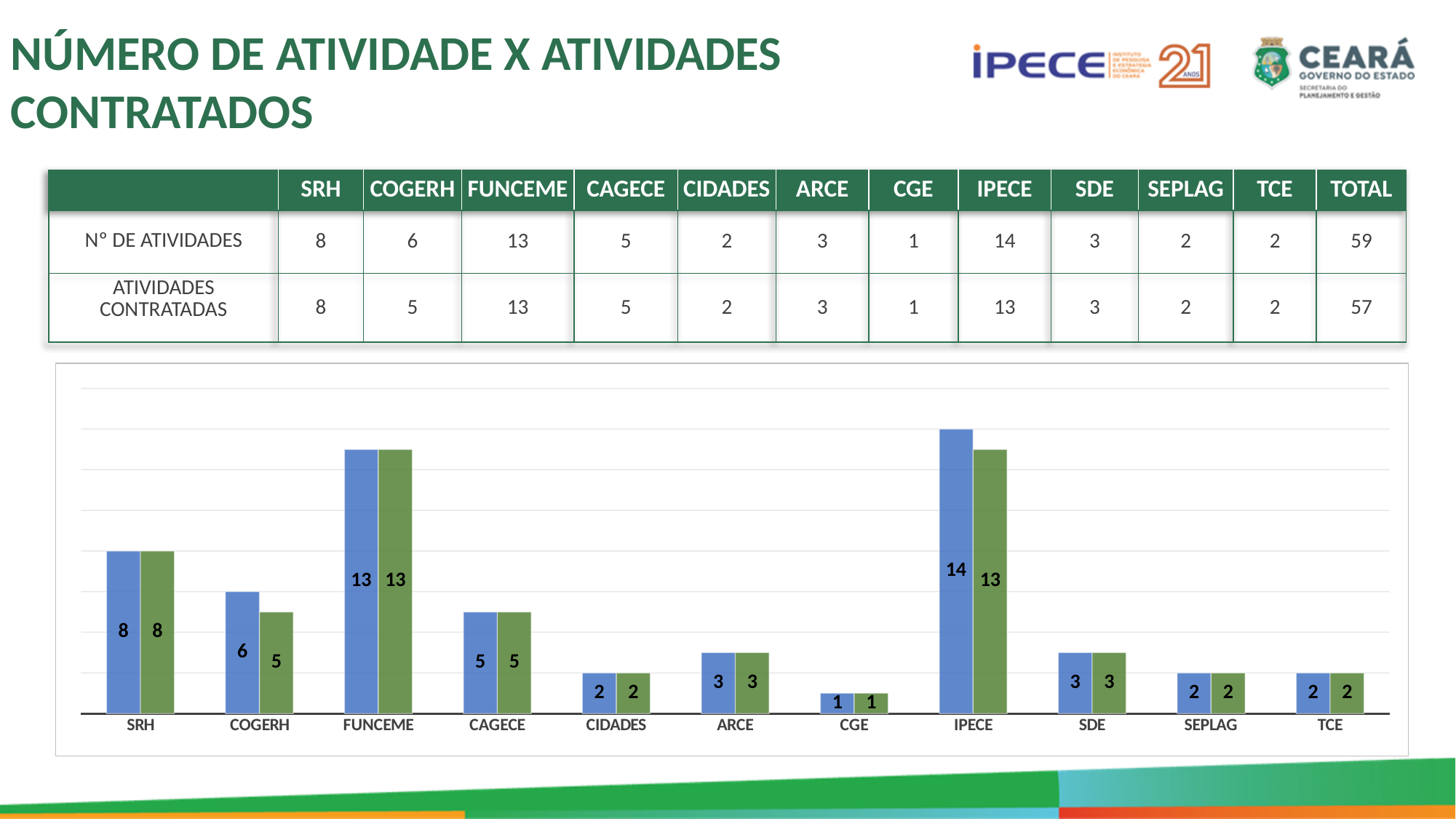
What is the value of the green bar for COGERH? 5 What type of chart is shown on the slide? bar chart Which category has the highest blue bar? IPECE What colour are the bars representing the first series (Nº de atividades) in the chart? blue What is the value of the blue bar for IPECE? 14 How many categories are shown along the x axis of the chart? 11 Which category has the lowest bars in the chart? CGE What is the difference between the blue bar and the green bar for IPECE? 1 What is the difference between the blue bar for SRH and the blue bar for CAGECE? 3 Which is larger for COGERH, the blue bar or the green bar? the blue bar Which is larger, the green bar for ARCE or the green bar for SDE? they are equal What is the value of the blue bar for FUNCEME? 13